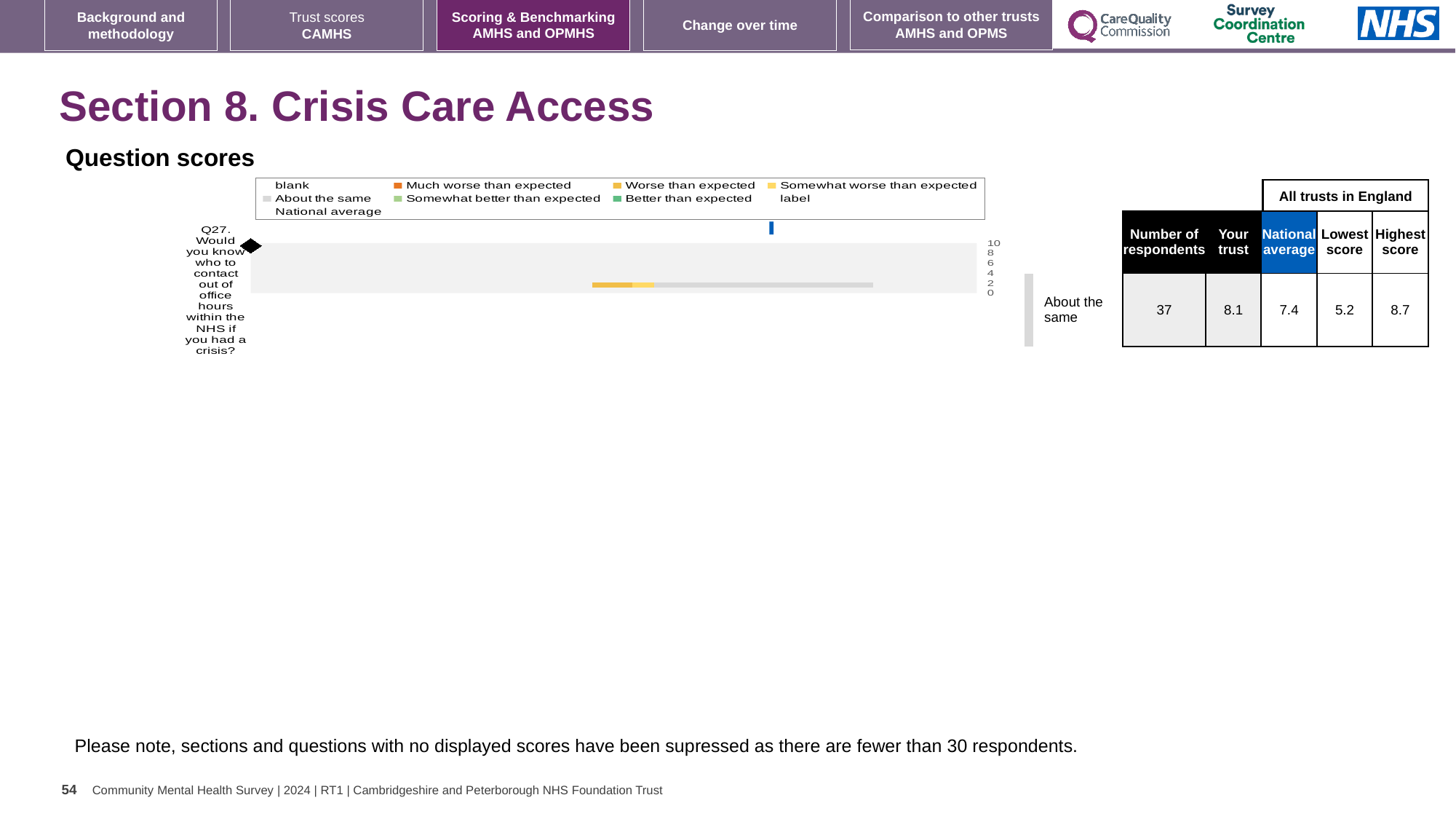
What is the lowest score among all trusts in England for Q27? 5.2 What is the 'Your trust' score for Q27 (knowing who to contact out of office hours in a crisis)? 8.1 Which is larger for Q27: the trust's score or the national average? Your trust What is the national average score for Q27? 7.4 What is the difference between the trust's score and the national average for Q27? 0.7 What is the highest score among all trusts in England for Q27? 8.7 What is the difference between the highest and lowest scores across all trusts in England for Q27? 3.5 How many respondents answered Q27? 37 What kind of chart is used to show the question score for Q27? bar chart Is the trust's score for Q27 greater or less than 6 on the chart axis? greater How many questions are plotted in the Question scores chart? 1 What benchmark category is shown next to the Q27 bar? About the same